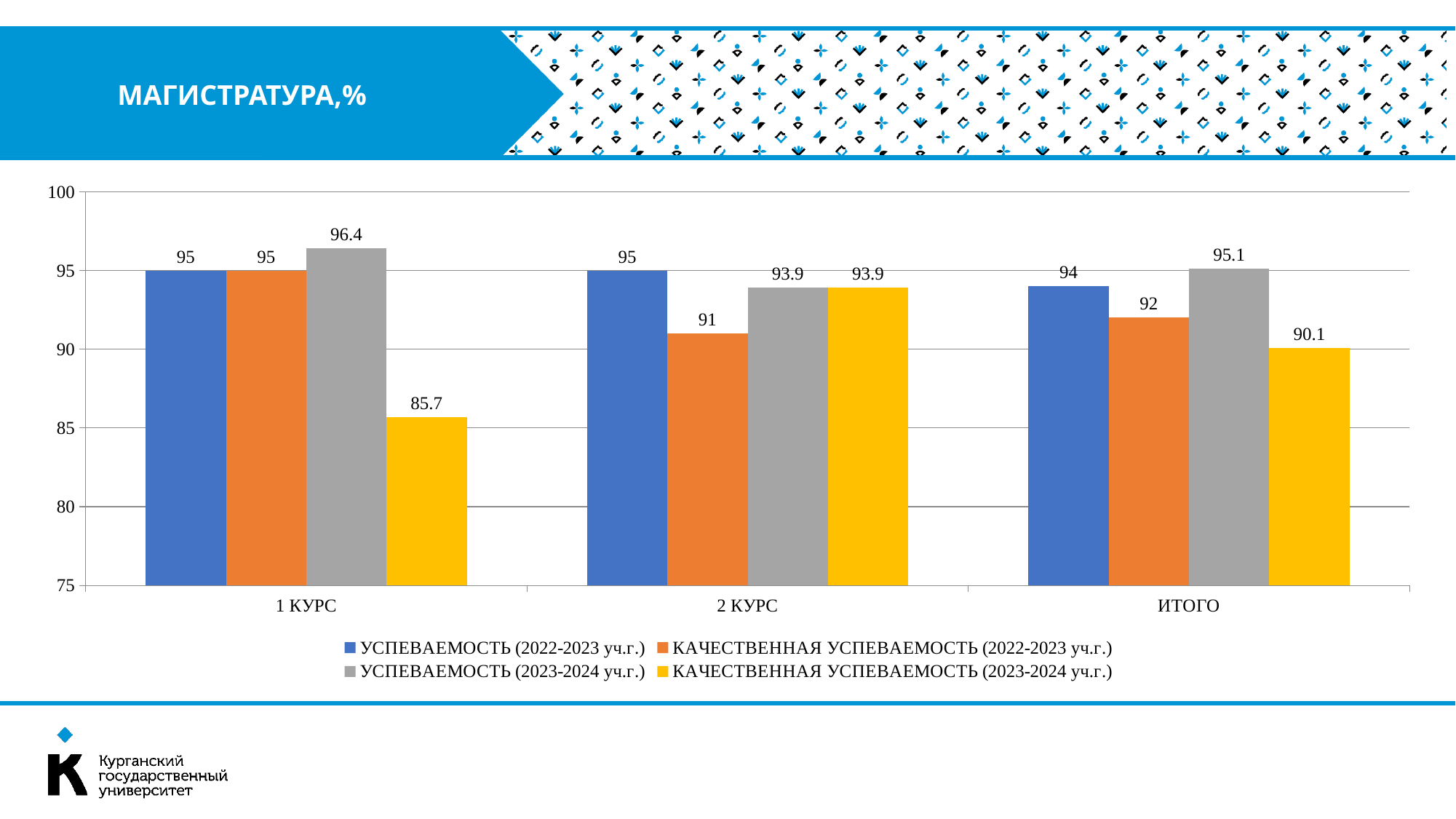
Which category has the lowest value for КАЧЕСТВЕННАЯ УСПЕВАЕМОСТЬ (2023-2024 уч.г.)? 1 КУРС How many categories are shown on the x axis? 3 What is the value of УСПЕВАЕМОСТЬ (2023-2024 уч.г.) for 1 КУРС? 96.4 What kind of chart is shown on the slide? bar chart How many series does the legend list? 4 Which is larger for ИТОГО: КАЧЕСТВЕННАЯ УСПЕВАЕМОСТЬ (2022-2023 уч.г.) or КАЧЕСТВЕННАЯ УСПЕВАЕМОСТЬ (2023-2024 уч.г.)? КАЧЕСТВЕННАЯ УСПЕВАЕМОСТЬ (2022-2023 уч.г.) What is the value of КАЧЕСТВЕННАЯ УСПЕВАЕМОСТЬ (2023-2024 уч.г.) for 1 КУРС? 85.7 Which category has the highest value for УСПЕВАЕМОСТЬ (2023-2024 уч.г.)? 1 КУРС What is the value of УСПЕВАЕМОСТЬ (2022-2023 уч.г.) for ИТОГО? 94 Is the value of КАЧЕСТВЕННАЯ УСПЕВАЕМОСТЬ (2023-2024 уч.г.) for ИТОГО greater or less than 85? greater What is the difference between УСПЕВАЕМОСТЬ (2023-2024 уч.г.) and КАЧЕСТВЕННАЯ УСПЕВАЕМОСТЬ (2023-2024 уч.г.) for 1 КУРС? 10.7 What is the value of КАЧЕСТВЕННАЯ УСПЕВАЕМОСТЬ (2022-2023 уч.г.) for 2 КУРС? 91